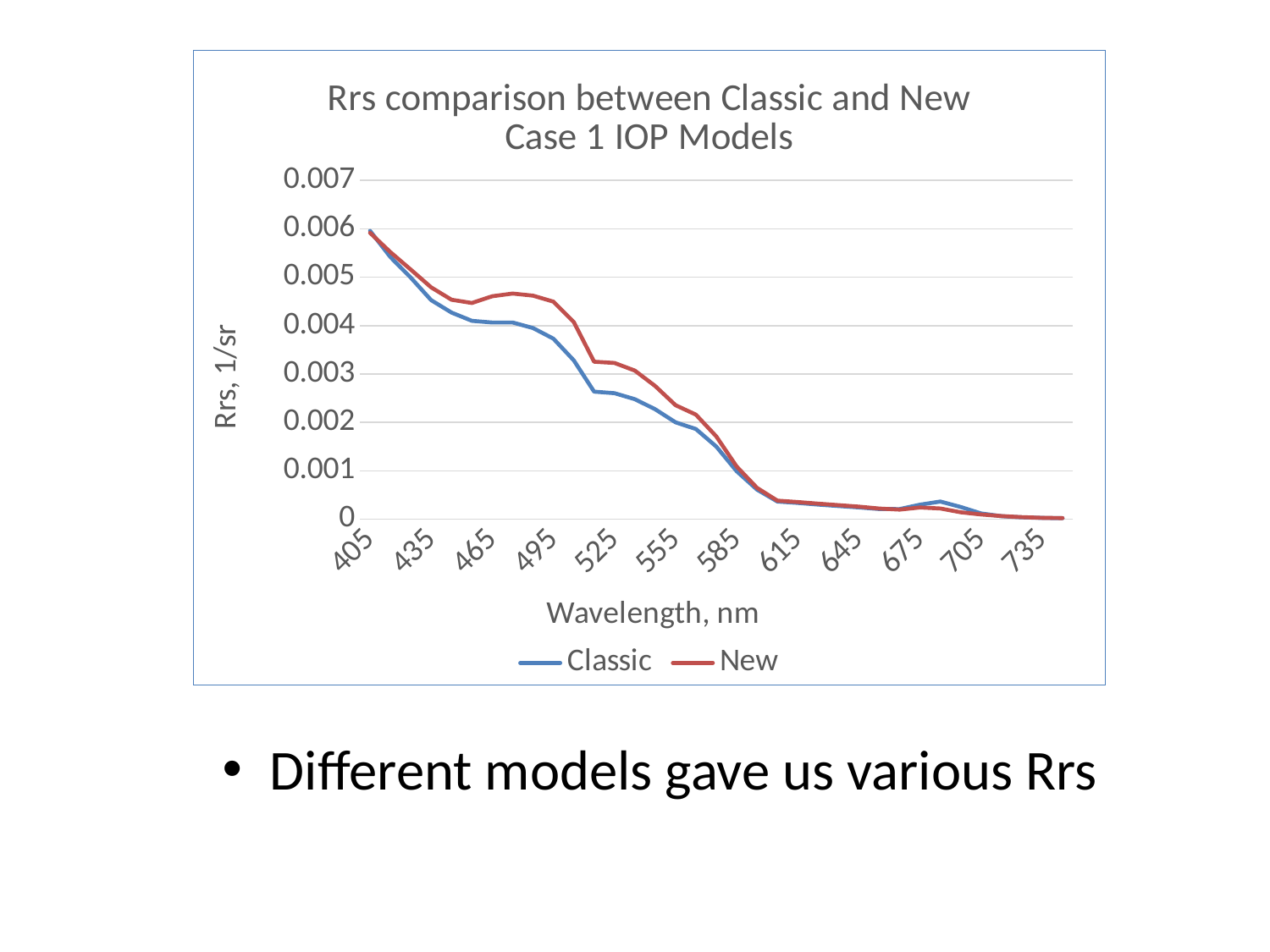
Is the Classic value at 405 nm greater or less than 0.005? greater How many series does the legend list? 2 Is the Classic value at 525 nm greater or less than 0.003? less Is the New value at 615 nm greater or less than 0.001? less At 555 nm, which series has the larger Rrs value, Classic or New? New What kind of chart is shown on the slide? line chart At 525 nm, which series has the larger Rrs value, Classic or New? New What is the title of the chart? Rrs comparison between Classic and New Case 1 IOP Models What is the label of the x axis? Wavelength, nm Do the Rrs values generally rise or fall as wavelength increases? fall